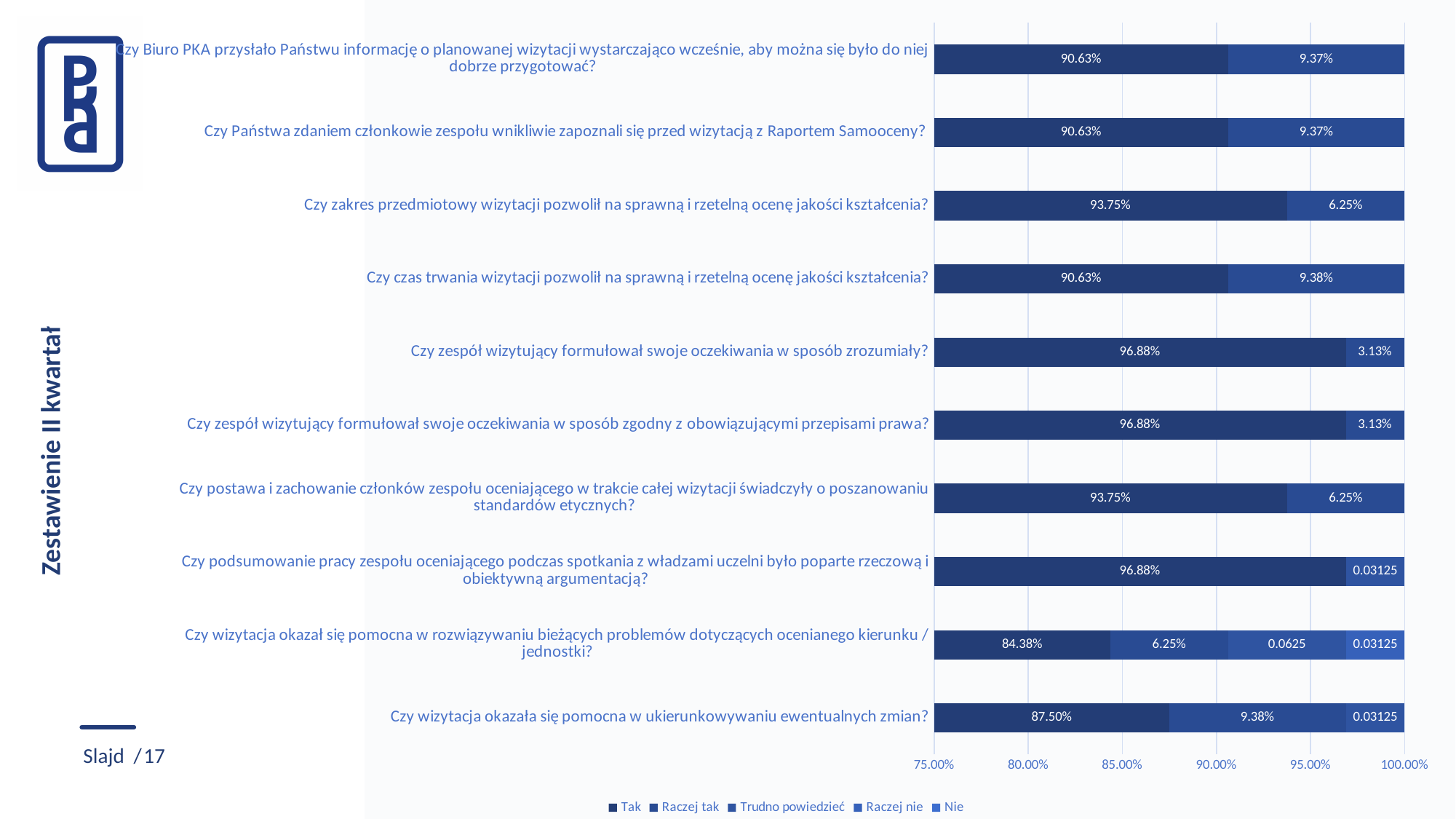
Which has the larger "Tak" value: "Czy czas trwania wizytacji pozwolił na sprawną i rzetelną ocenę jakości kształcenia?" or "Czy postawa i zachowanie członków zespołu oceniającego w trakcie całej wizytacji świadczyły o poszanowaniu standardów etycznych?"? Czy postawa i zachowanie członków zespołu oceniającego w trakcie całej wizytacji świadczyły o poszanowaniu standardów etycznych? What is the difference between the "Tak" value for "Czy zespół wizytujący formułował swoje oczekiwania w sposób zrozumiały?" and the "Tak" value for "Czy wizytacja okazał się pomocna w rozwiązywaniu bieżących problemów dotyczących ocenianego kierunku / jednostki?"? 12.50% What is the highest "Tak" value shown in the chart? 96.88% How many series does the legend list? 5 What is the "Tak" value for "Czy zakres przedmiotowy wizytacji pozwolił na sprawną i rzetelną ocenę jakości kształcenia?"? 93.75% What is the first entry in the chart's legend? Tak Which question has the lowest "Tak" value? Czy wizytacja okazał się pomocna w rozwiązywaniu bieżących problemów dotyczących ocenianego kierunku / jednostki? How many questions (categories) are plotted in the chart? 10 Is the "Tak" value for "Czy wizytacja okazała się pomocna w ukierunkowywaniu ewentualnych zmian?" greater or less than 90.00%? less What kind of chart is shown on the slide? bar chart What is the "Tak" value for "Czy Państwa zdaniem członkowie zespołu wnikliwie zapoznali się przed wizytacją z Raportem Samooceny?"? 90.63% What is the "Tak" value for "Czy wizytacja okazała się pomocna w ukierunkowywaniu ewentualnych zmian?"? 87.50%